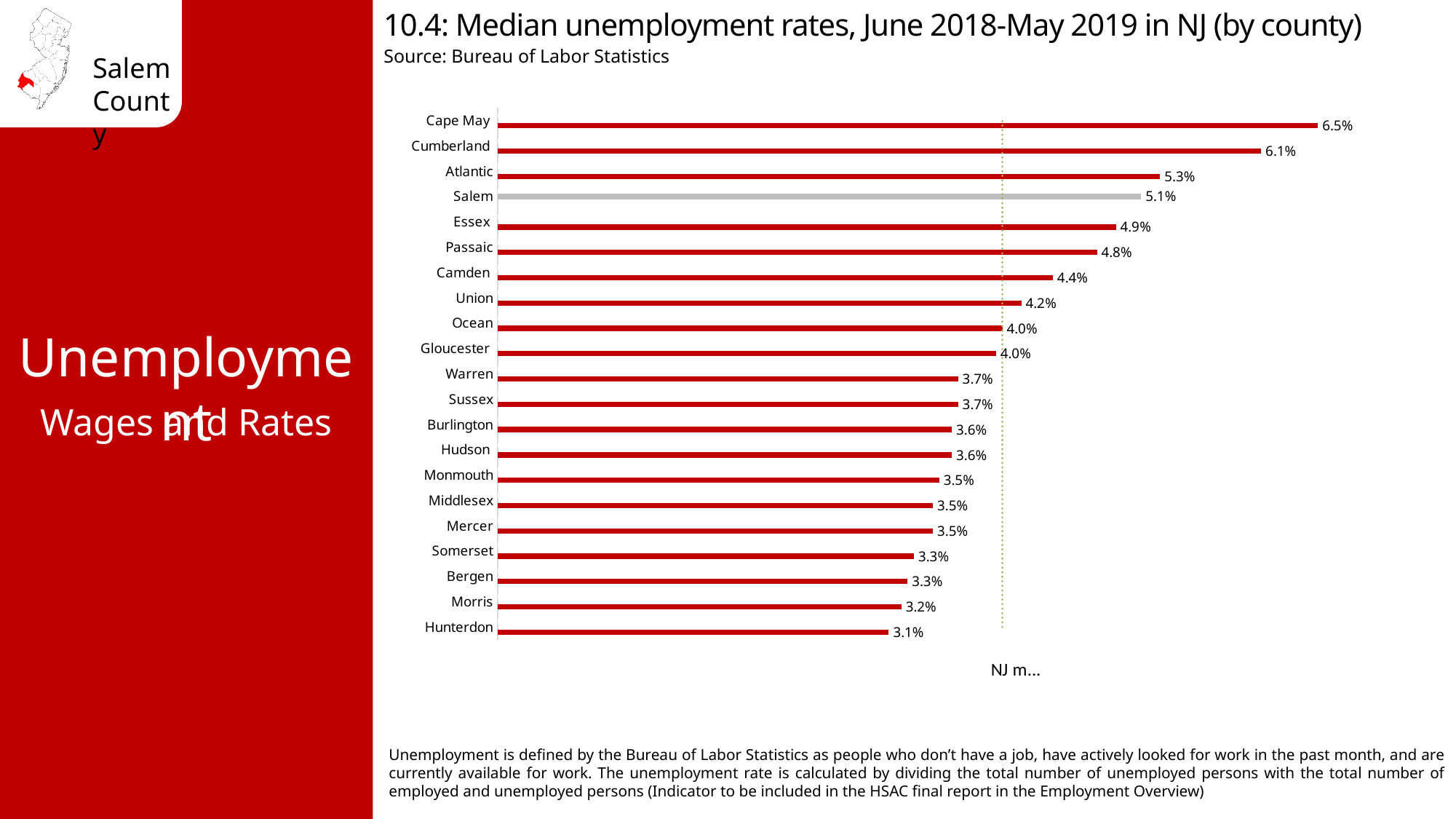
What type of chart is used to show the median unemployment rates? Bar chart Which county has the highest median unemployment rate? Cape May What is the median unemployment rate for Hunterdon County? 3.1% What is the median unemployment rate for Passaic County? 4.8% Which county's bar is shown in gray instead of red? Salem Which county has a higher median unemployment rate, Camden or Morris? Camden What is the difference between the median unemployment rates of Cape May and Salem? 1.4% Which county has a higher median unemployment rate, Atlantic or Essex? Atlantic Which county has the lowest median unemployment rate? Hunterdon What is the median unemployment rate for Cumberland County? 6.1% How many counties are shown in the chart? 21 What is the median unemployment rate for Salem County? 5.1%